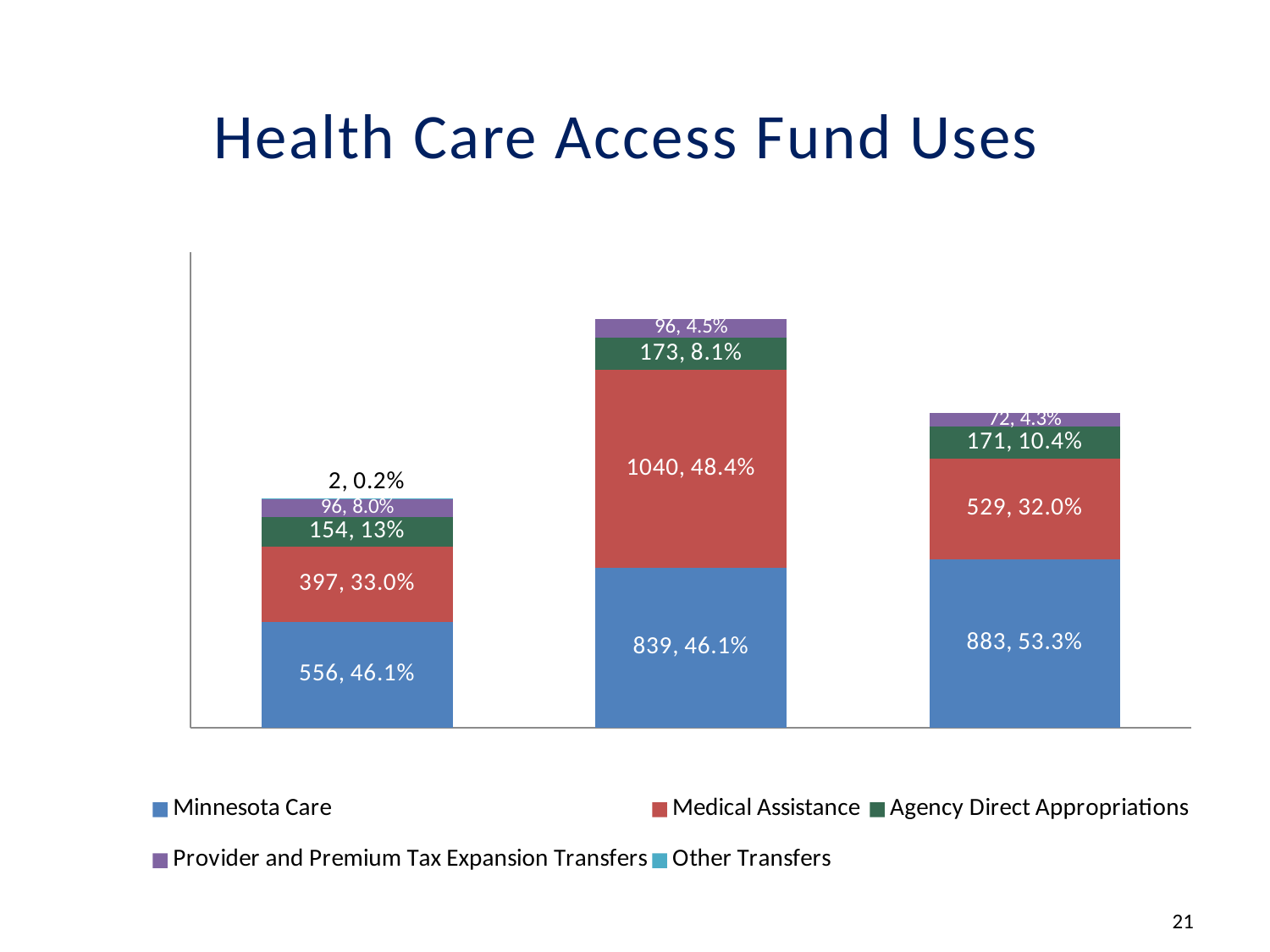
How many bars are plotted in the chart? 3 Which bar has the largest Medical Assistance value? The middle bar What is the Minnesota Care value in the left bar? 556 What is the difference between the Minnesota Care values in the right bar and the left bar? 327 What kind of chart is shown on the slide? Stacked bar chart What percentage share does Agency Direct Appropriations have in the right bar? 10.4% What is the Medical Assistance value in the middle bar? 1040 Which is larger in the middle bar, Minnesota Care or Medical Assistance? Medical Assistance What is the total of the right bar? 1655 What is the title of the chart? Health Care Access Fund Uses How many series does the legend list? 5 What is the Provider and Premium Tax Expansion Transfers value in the right bar? 72